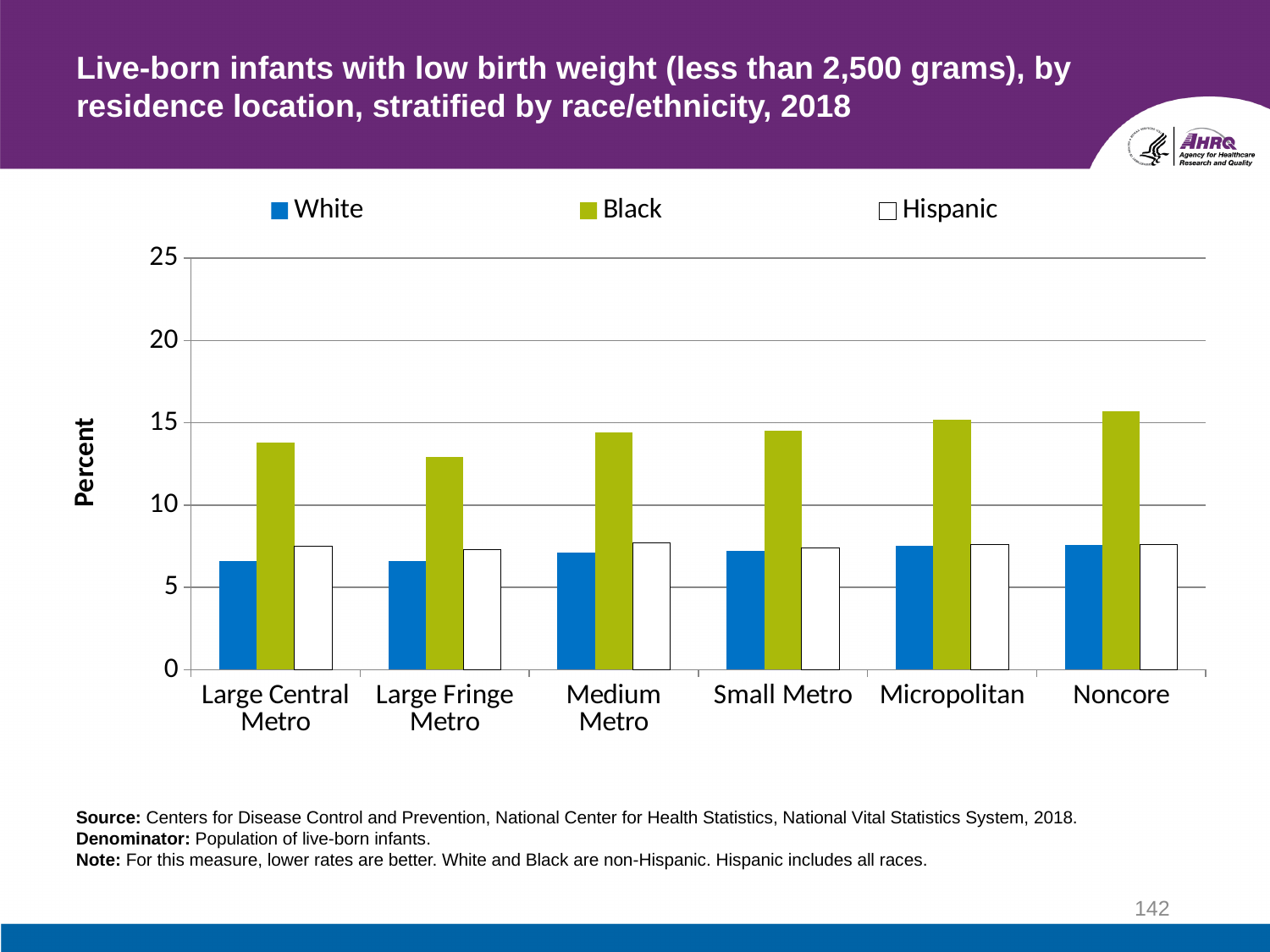
Is the value for White in Large Central Metro greater or less than 5? greater In Noncore, which is larger, the value for Black or the value for White? Black How many residence location categories are shown on the x axis? 6 Is the value for Hispanic in Medium Metro greater or less than 10? less Is the value for Black in Noncore greater or less than 15? greater Which residence location has the lowest value for Black? Large Fringe Metro Which residence location has the highest value for Black? Noncore What kind of chart is shown on the slide? Bar chart How many series does the legend list? 3 In Large Central Metro, which is larger, the value for Hispanic or the value for White? Hispanic What is the label on the y axis? Percent